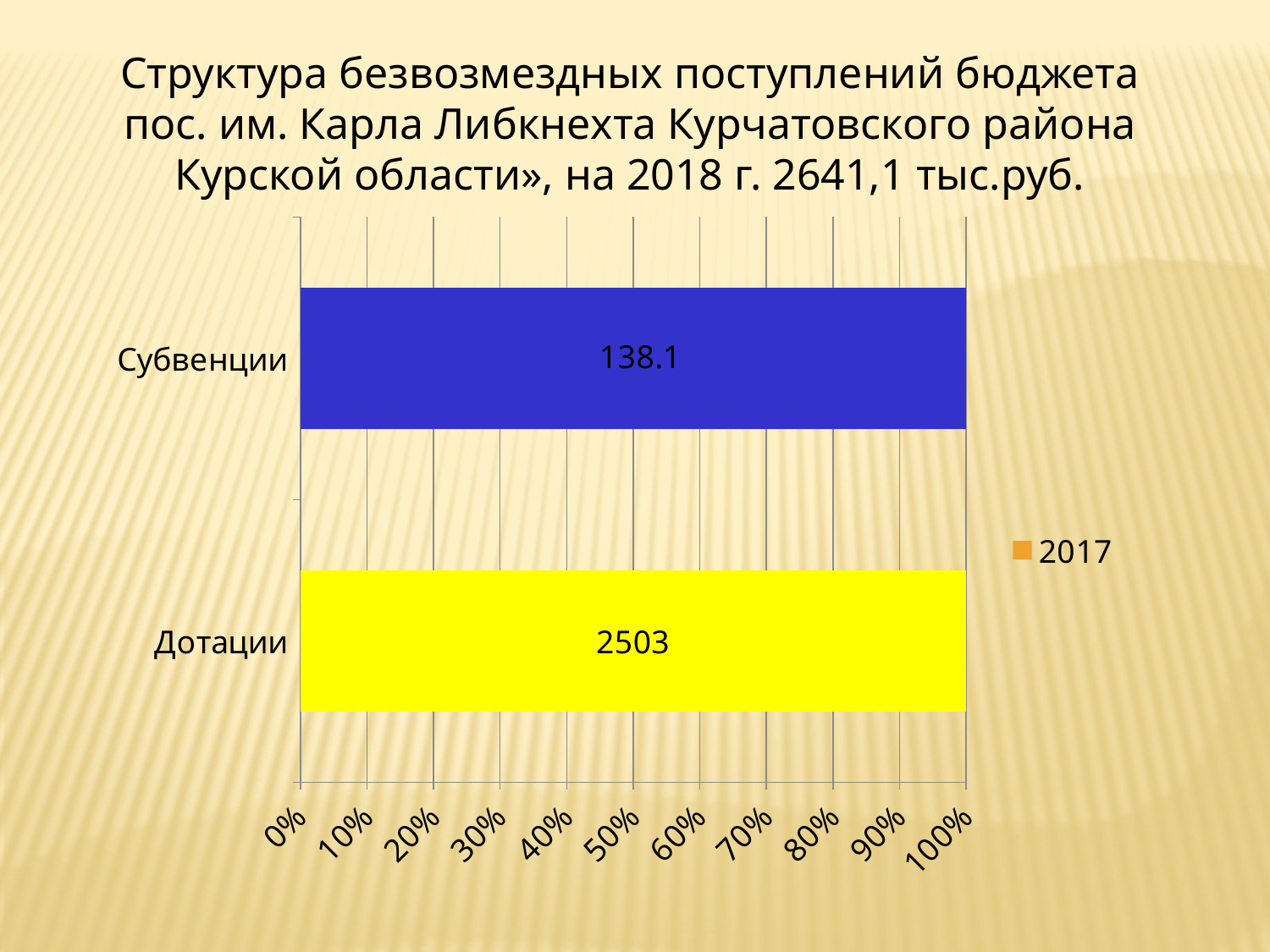
Which category has the highest labelled value? Дотации Which category has the larger labelled value, Субвенции or Дотации? Дотации What kind of chart is shown on the slide? Bar chart How many categories are shown on the chart? 2 What colour is the bar for Дотации? Yellow What is the data label on the bar for Дотации? 2503 Which category has the lowest labelled value? Субвенции What is the data label on the bar for Субвенции? 138.1 What entry is shown in the chart legend? 2017 What is the difference between the labelled values for Дотации and Субвенции? 2364.9 How many series does the legend list? 1